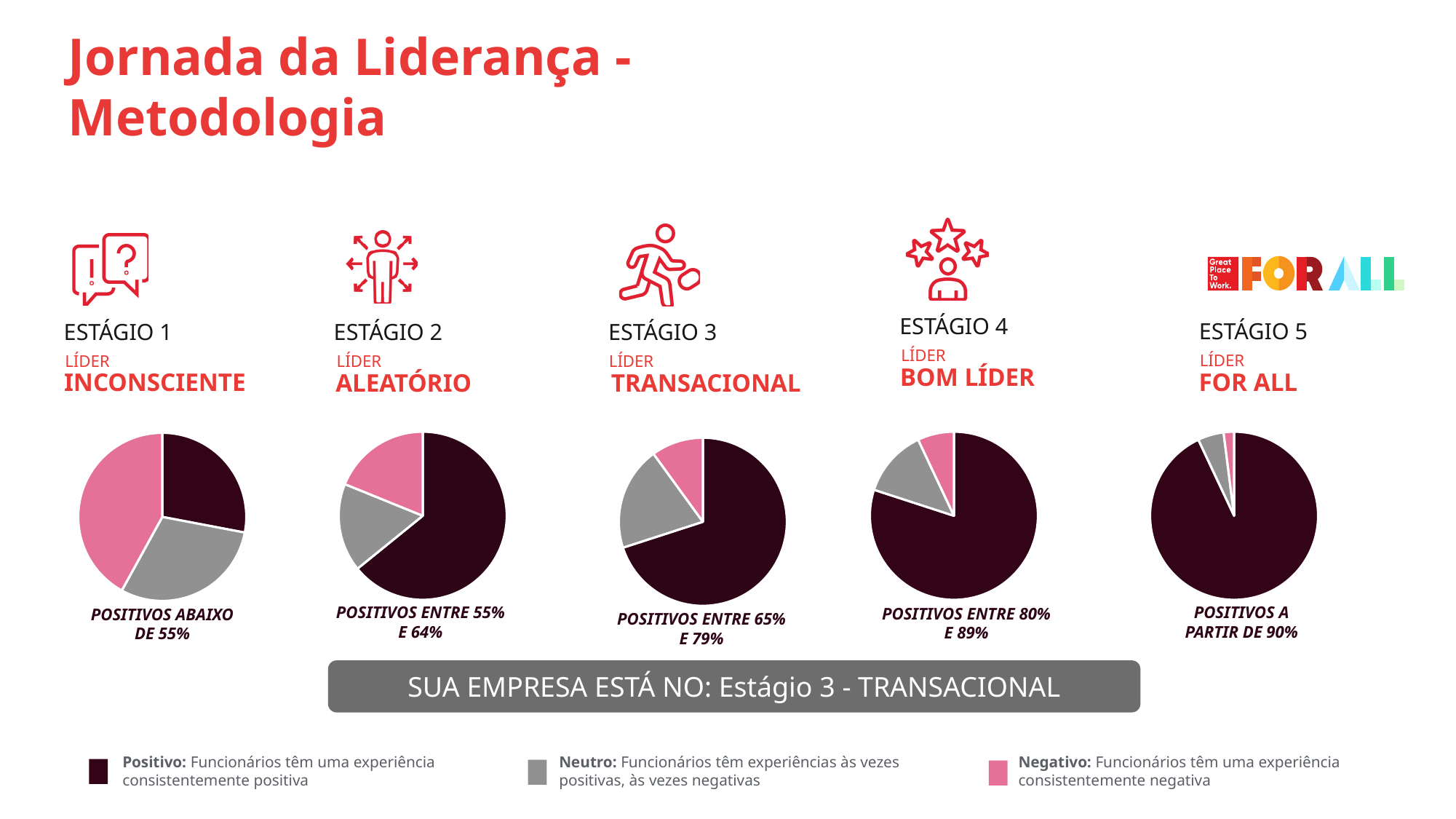
In the Estágio 5 pie chart, which category has the largest slice? Positivo How many pie charts are shown on the slide? 5 In the Estágio 5 pie chart, which category has the smallest slice? Negativo How many categories does the legend at the bottom of the slide list? 3 Does the Positivo slice grow or shrink going from Estágio 1 to Estágio 5? grows What kind of chart is used to show the experience breakdown for each stage? pie chart In the Estágio 2 pie chart, which slice is larger, Positivo or Negativo? Positivo In the Estágio 4 pie chart, which category has the smallest slice? Negativo How many slices does the Estágio 3 pie chart have? 3 Which colour represents Negativo in the legend? pink In the Estágio 3 pie chart, which slice is larger, Neutro or Negativo? Neutro According to the banner below the pie charts, which stage is the company in? Estágio 3 - Transacional